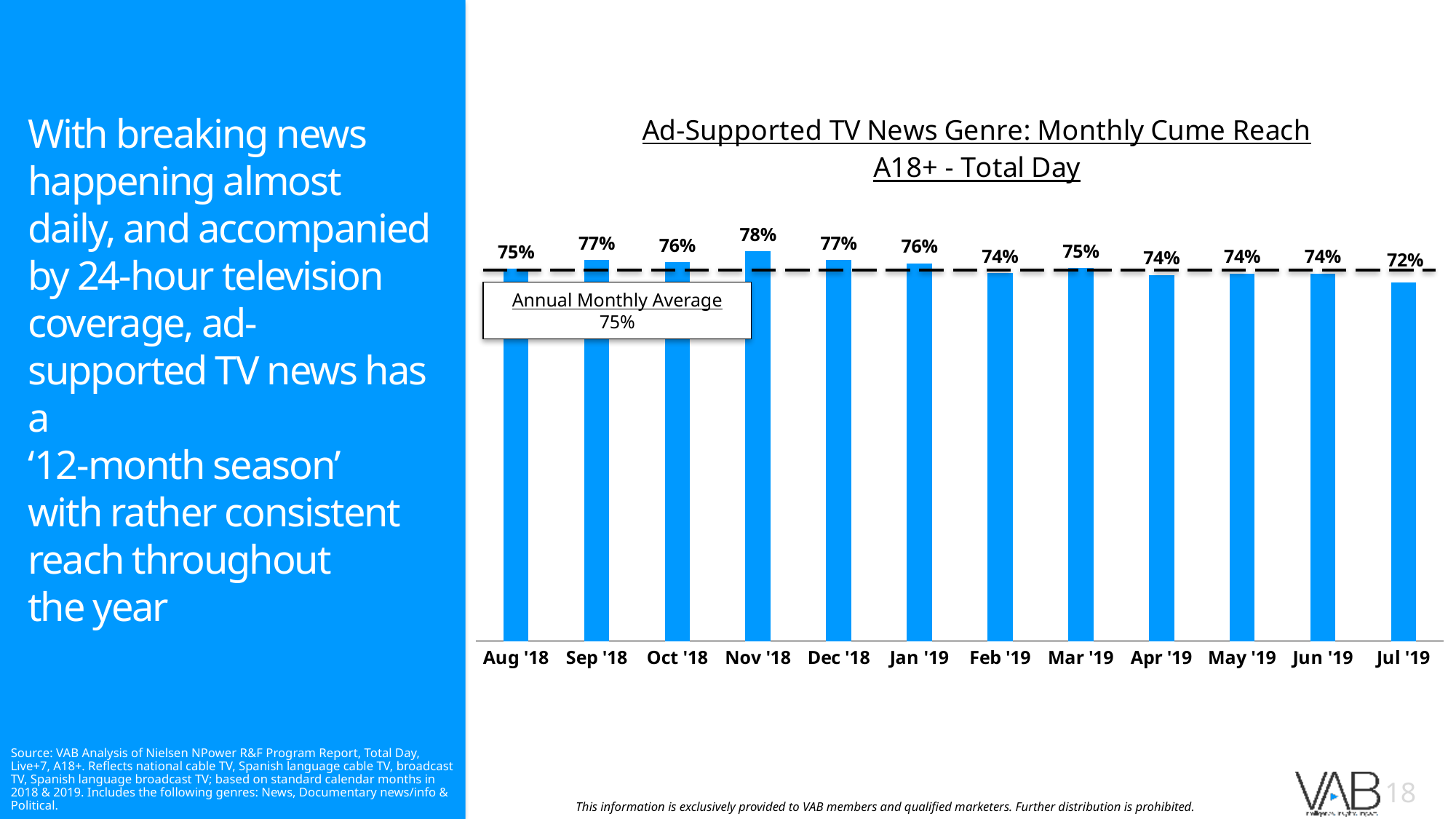
What is the monthly cume reach for Nov '18? 78% What is the annual monthly average shown on the chart? 75% What is the title of the chart? Ad-Supported TV News Genre: Monthly Cume Reach A18+ - Total Day Which month has the highest monthly cume reach? Nov '18 What is the difference in reach between Nov '18 and Jul '19? 6% How many months are shown on the chart? 12 Does the reach rise or fall from Nov '18 to Jul '19? Fall Which has a higher reach, Sep '18 or Feb '19? Sep '18 What is the monthly cume reach for Mar '19? 75% What is the monthly cume reach for Jul '19? 72% Which month has the lowest monthly cume reach? Jul '19 What kind of chart is shown on the slide? Bar chart